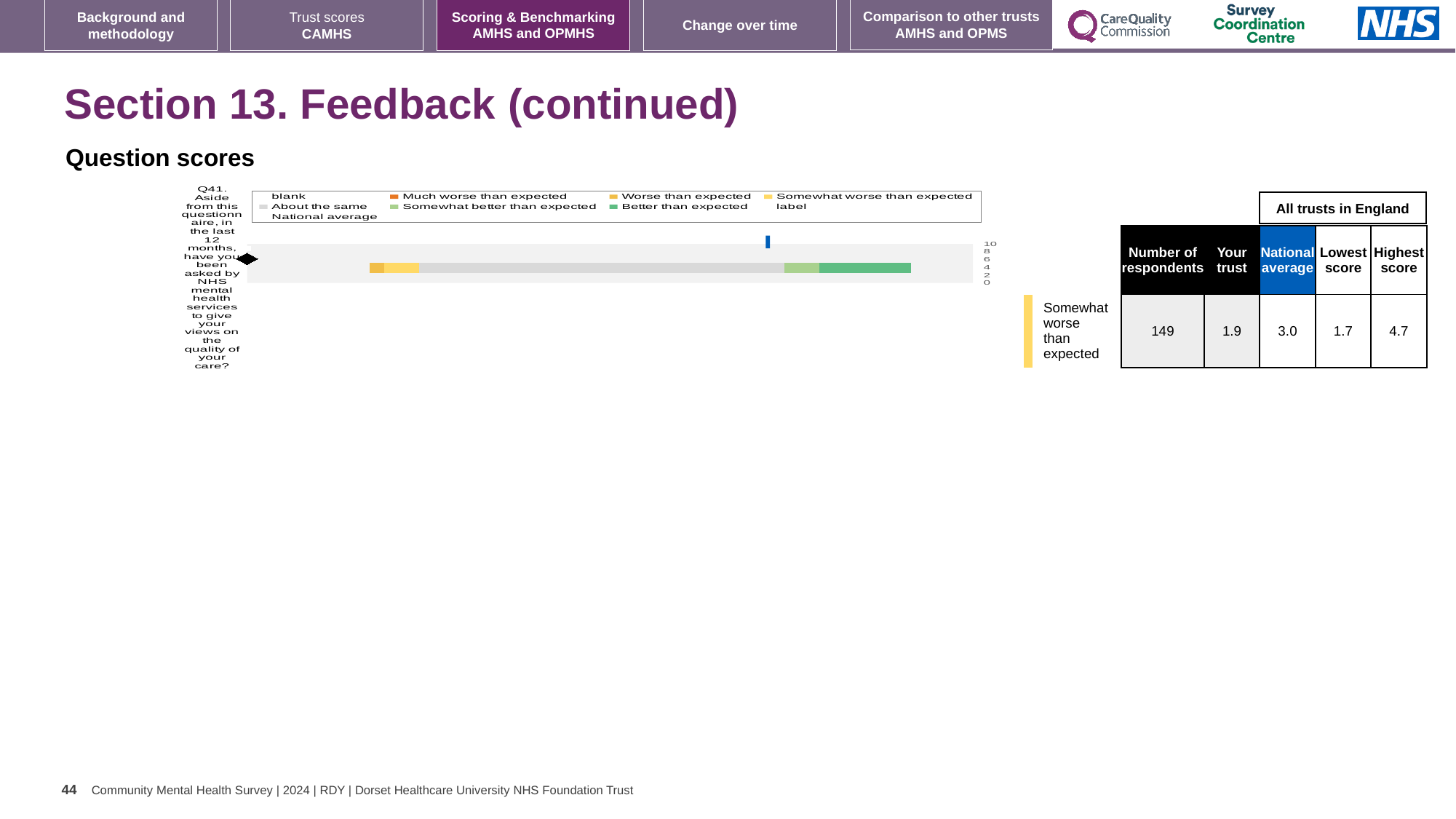
What is the difference between the highest score and the lowest score for Q41? 3.0 What is the lowest score among all trusts in England for Q41? 1.7 How many survey questions are plotted in the chart? 1 How many respondents answered Q41? 149 What is the 'Your trust' score for Q41? 1.9 What colour does the legend use for 'Much worse than expected'? orange Is the trust's score for Q41 higher or lower than the national average? lower What is the highest score among all trusts in England for Q41? 4.7 What is the national average score for Q41? 3.0 What kind of chart is shown on the slide? bar chart Which benchmark category is the trust's Q41 score placed in? Somewhat worse than expected Which question number is plotted in the chart? Q41